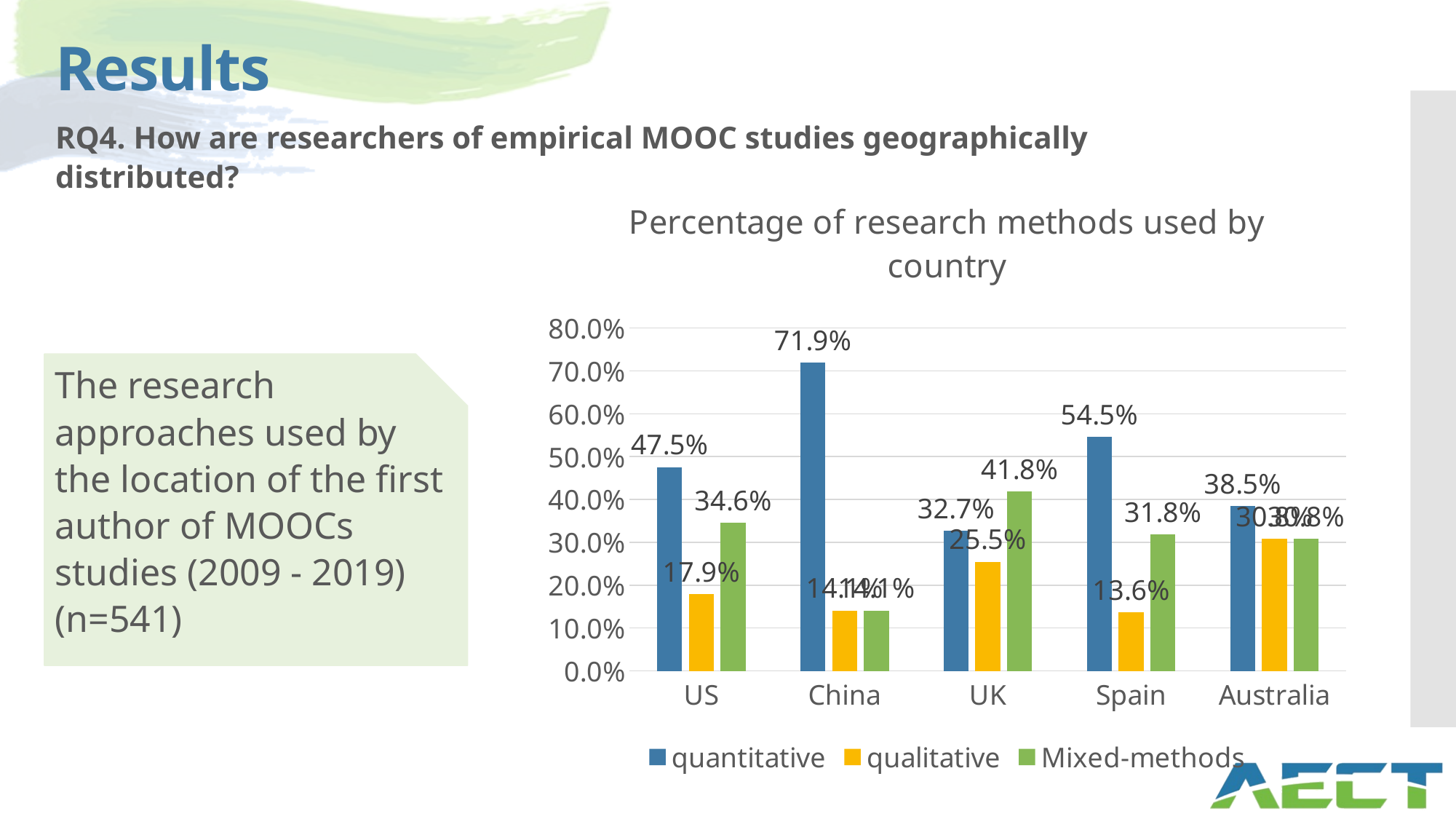
Which country has the highest Mixed-methods value? UK What kind of chart is shown on the slide? bar chart Is the quantitative value for Spain greater or less than 50%? greater What is the qualitative value for Spain? 13.6% What is the difference between the quantitative values for China and the US? 24.4% What is the quantitative value for China? 71.9% How many countries are shown on the x axis? 5 Which country has the highest quantitative value? China What is the Mixed-methods value for the UK? 41.8% What is the quantitative value for the US? 47.5% For the UK, which is larger: the quantitative value or the Mixed-methods value? Mixed-methods How many series does the legend list? 3